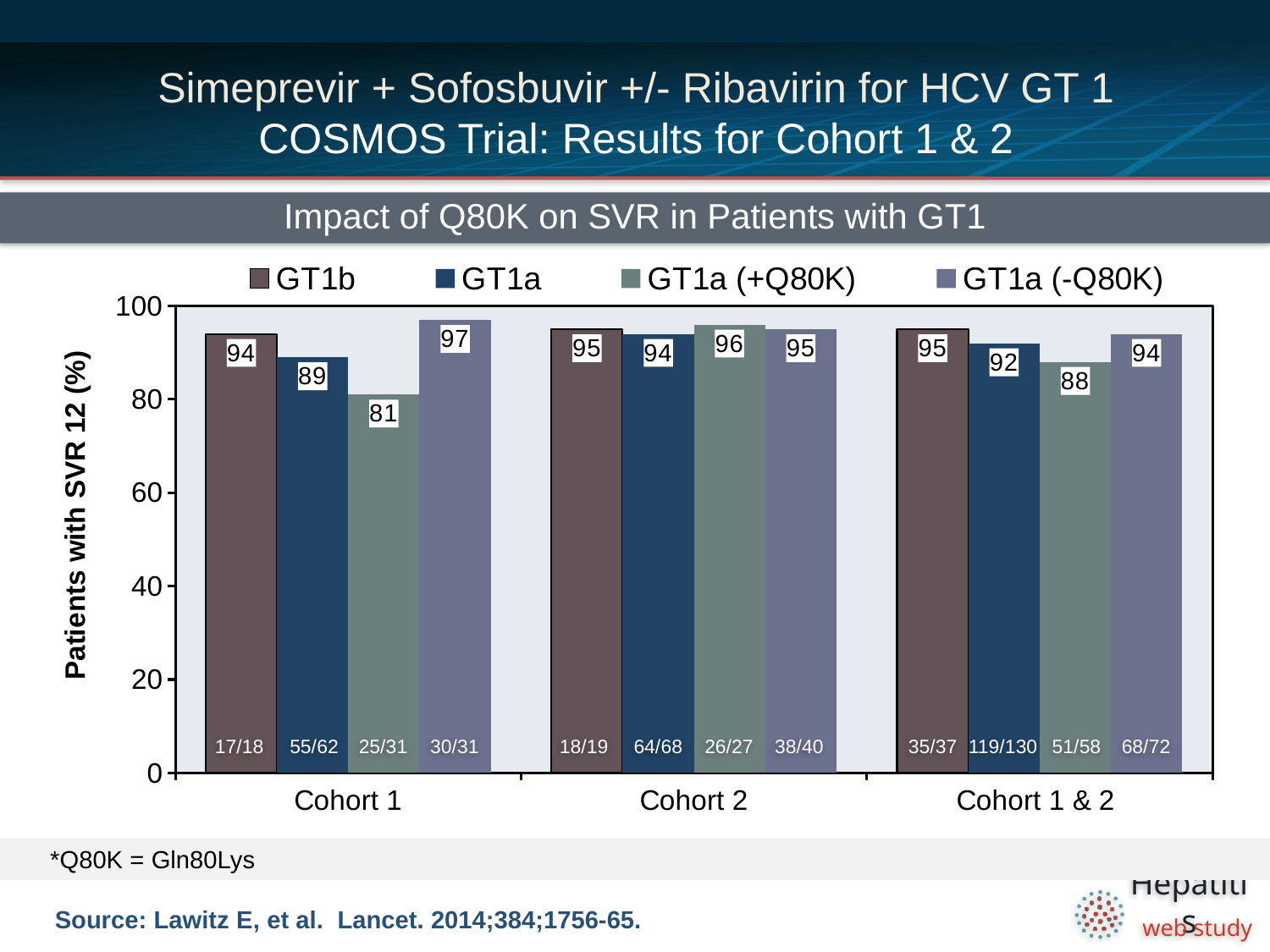
What is the SVR 12 value for GT1a (-Q80K) in Cohort 1? 97 In Cohort 1 & 2, which is larger: the GT1b value or the GT1a (+Q80K) value? GT1b How many series does the legend list? 4 What is the SVR 12 value for GT1a in Cohort 1 & 2? 92 How many cohort groups are shown on the x axis? 3 What is the title of the chart? Impact of Q80K on SVR in Patients with GT1 What is the SVR 12 value for GT1a (+Q80K) in Cohort 1? 81 Which series has the highest SVR 12 value in Cohort 1? GT1a (-Q80K) Which series has the lowest SVR 12 value in Cohort 1? GT1a (+Q80K) What is the SVR 12 value for GT1a (+Q80K) in Cohort 2? 96 What kind of chart is shown on the slide? Bar chart What is the difference between the GT1a (-Q80K) and GT1a (+Q80K) values in Cohort 1? 16